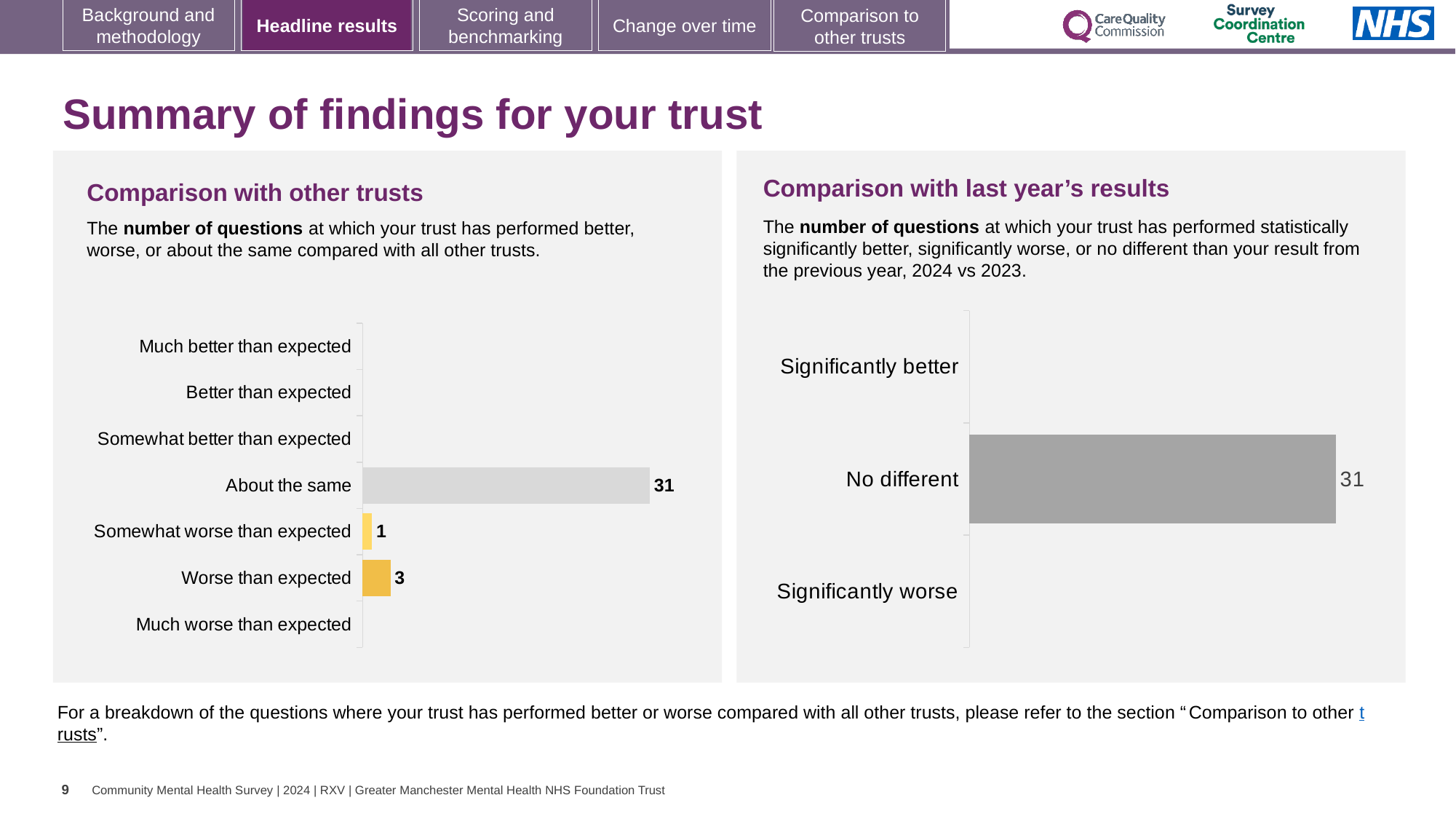
In the 'Comparison with other trusts' chart, what is the difference between 'About the same' and 'Worse than expected'? 28 What kind of chart is the 'Comparison with other trusts' chart? Bar chart How many categories are listed on the axis of the 'Comparison with last year's results' chart? 3 In the 'Comparison with other trusts' chart, what is the value for 'Worse than expected'? 3 What is the title of the chart on the right side of the slide? Comparison with last year's results In the 'Comparison with other trusts' chart, which is larger: 'Worse than expected' or 'Somewhat worse than expected'? Worse than expected In the 'Comparison with last year's results' chart, which category has the highest value? No different In the 'Comparison with other trusts' chart, what is the value for 'Somewhat worse than expected'? 1 In the 'Comparison with other trusts' chart, what is the value for 'About the same'? 31 In the 'Comparison with last year's results' chart, what is the value for 'No different'? 31 How many categories are listed on the axis of the 'Comparison with other trusts' chart? 7 In the 'Comparison with other trusts' chart, which category has the highest value? About the same